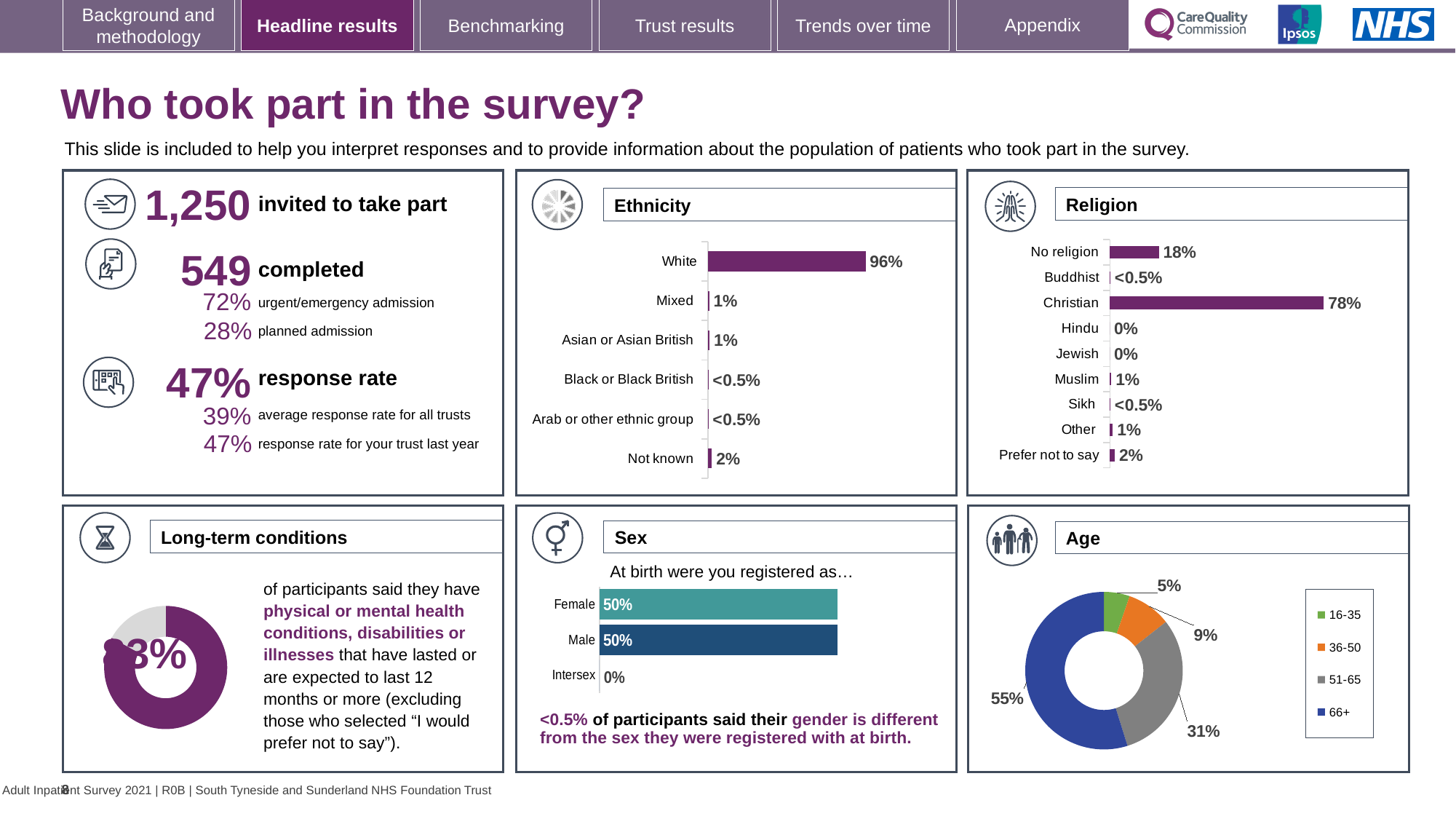
In the Ethnicity chart, what is the value for Not known? 2% In the Religion chart, what is the difference between the Christian and No religion values? 60% How many ethnic group categories are shown in the Ethnicity chart? 6 In the Ethnicity chart, what percentage of participants were White? 96% In the Religion chart, what percentage of participants were Christian? 78% In the Sex chart, what percentage of participants were registered as Female at birth? 50% In the Ethnicity chart, which ethnic group has the highest percentage? White In the Religion chart, which is larger, the value for Prefer not to say or the value for Muslim? Prefer not to say In the Age chart, what share of participants were aged 66+? 55% What type of chart is the Age chart? Doughnut (pie) chart In the Age chart, which age group has the smallest share? 16-35 In the Religion chart, what is the value for No religion? 18%